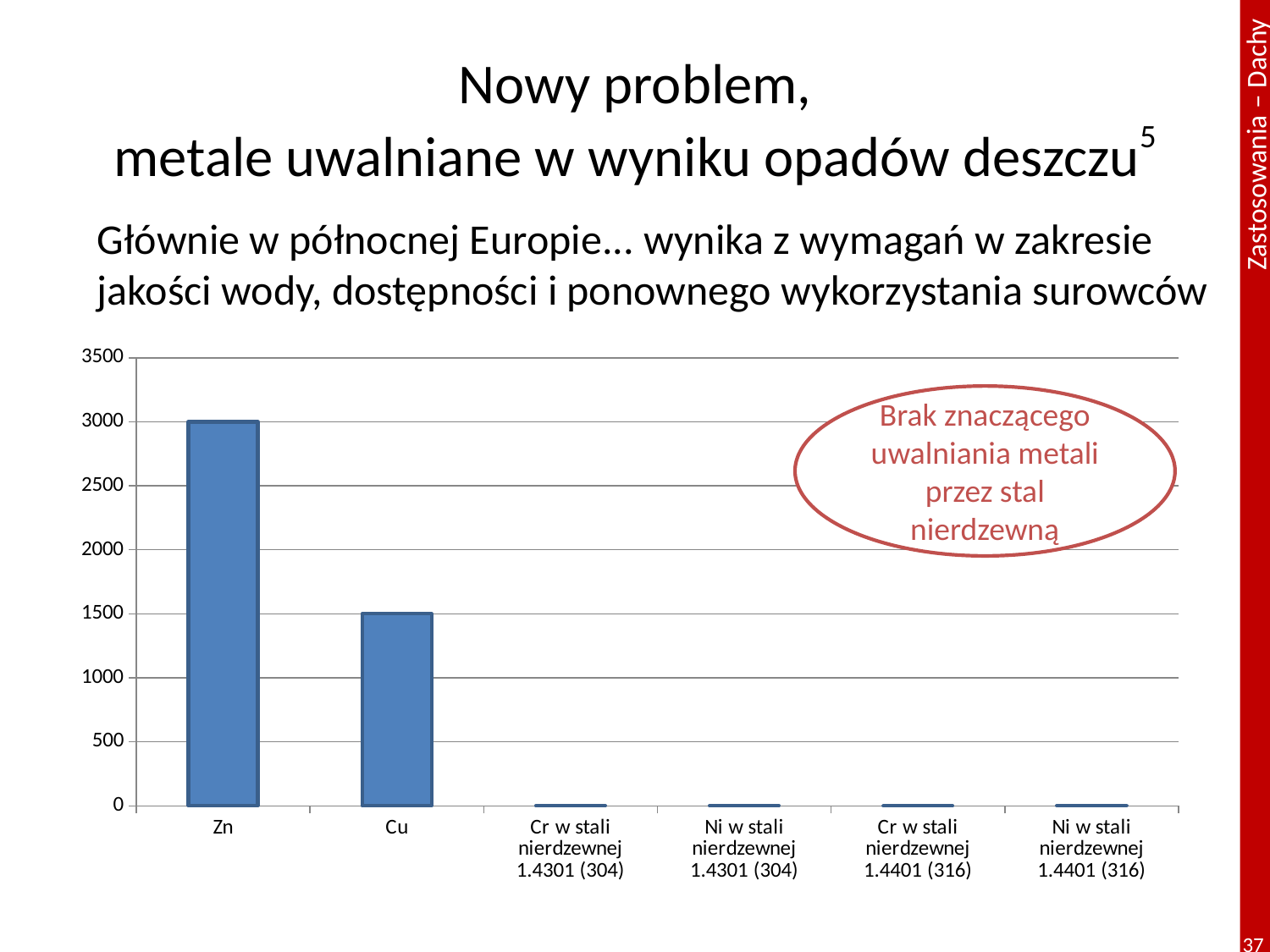
What text is written inside the red oval annotation on the chart? Brak znaczącego uwalniania metali przez stal nierdzewną Is the value for Ni w stali nierdzewnej 1.4401 (316) greater or less than 500? less What is the difference between the values for Zn and Cu? 1500 What is the value for Cu in the chart? 1500 Which is larger, the value for Zn or the value for Cu? Zn Is the value for Cu greater or less than 1000? greater What is the highest value shown on the vertical axis of the chart? 3500 Which category has the highest bar in the chart? Zn What kind of chart is shown on the slide? bar chart Is the value for Cr w stali nierdzewnej 1.4301 (304) greater or less than 500? less What is the value for Zn in the chart? 3000 How many categories are shown on the x axis of the chart? 6